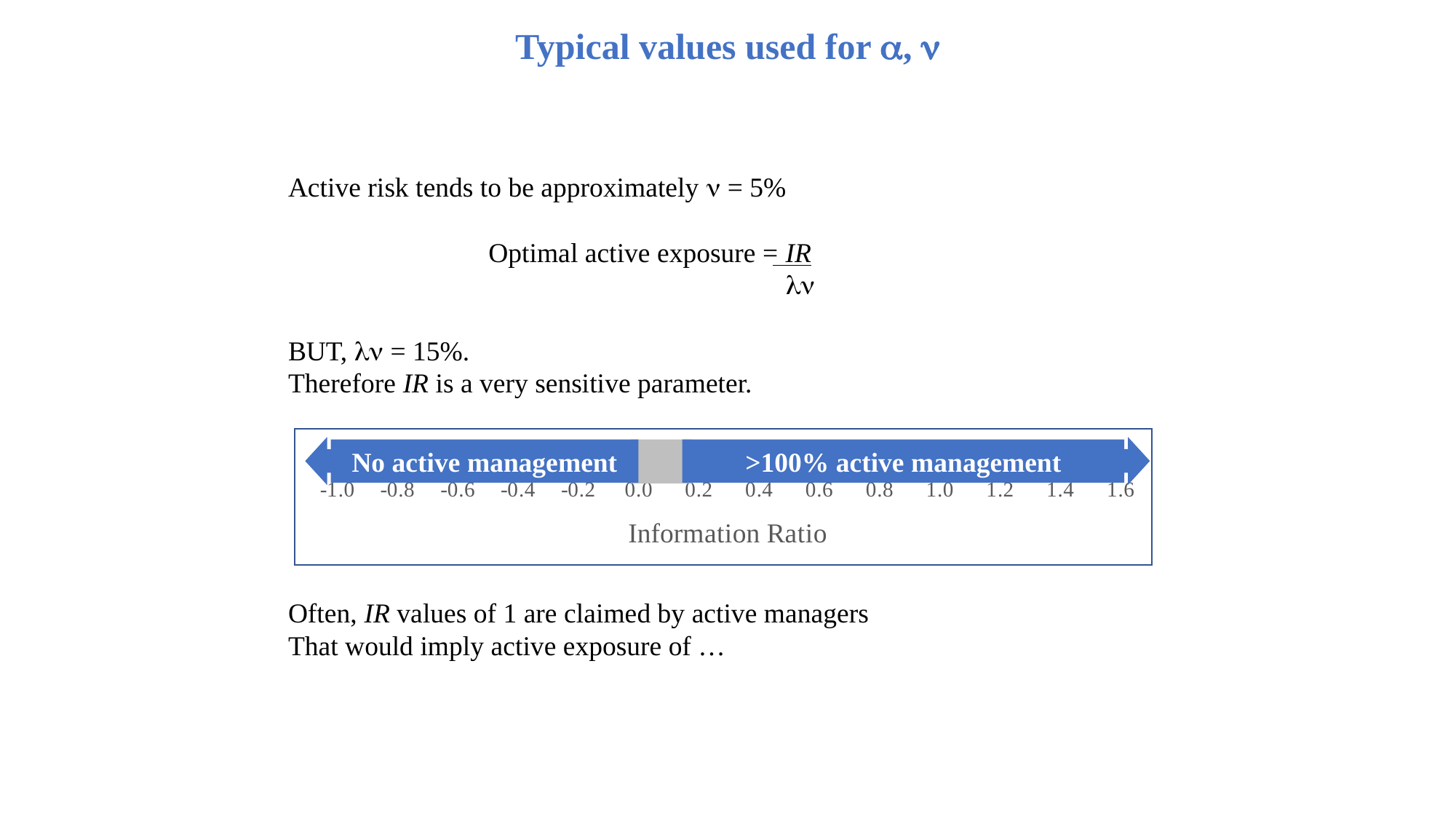
What is the highest value shown on the Information Ratio axis? 1.6 What is the spacing between consecutive tick values on the Information Ratio axis? 0.2 How many tick values are printed along the Information Ratio axis? 14 Is the grey gap between the two blue regions located above or below an Information Ratio of 0.0? above What label is printed on the right blue region of the Information Ratio diagram? >100% active management What label is printed on the left blue region of the Information Ratio diagram? No active management What is the lowest value shown on the Information Ratio axis? -1.0 What is the label of the horizontal axis in the diagram? Information Ratio